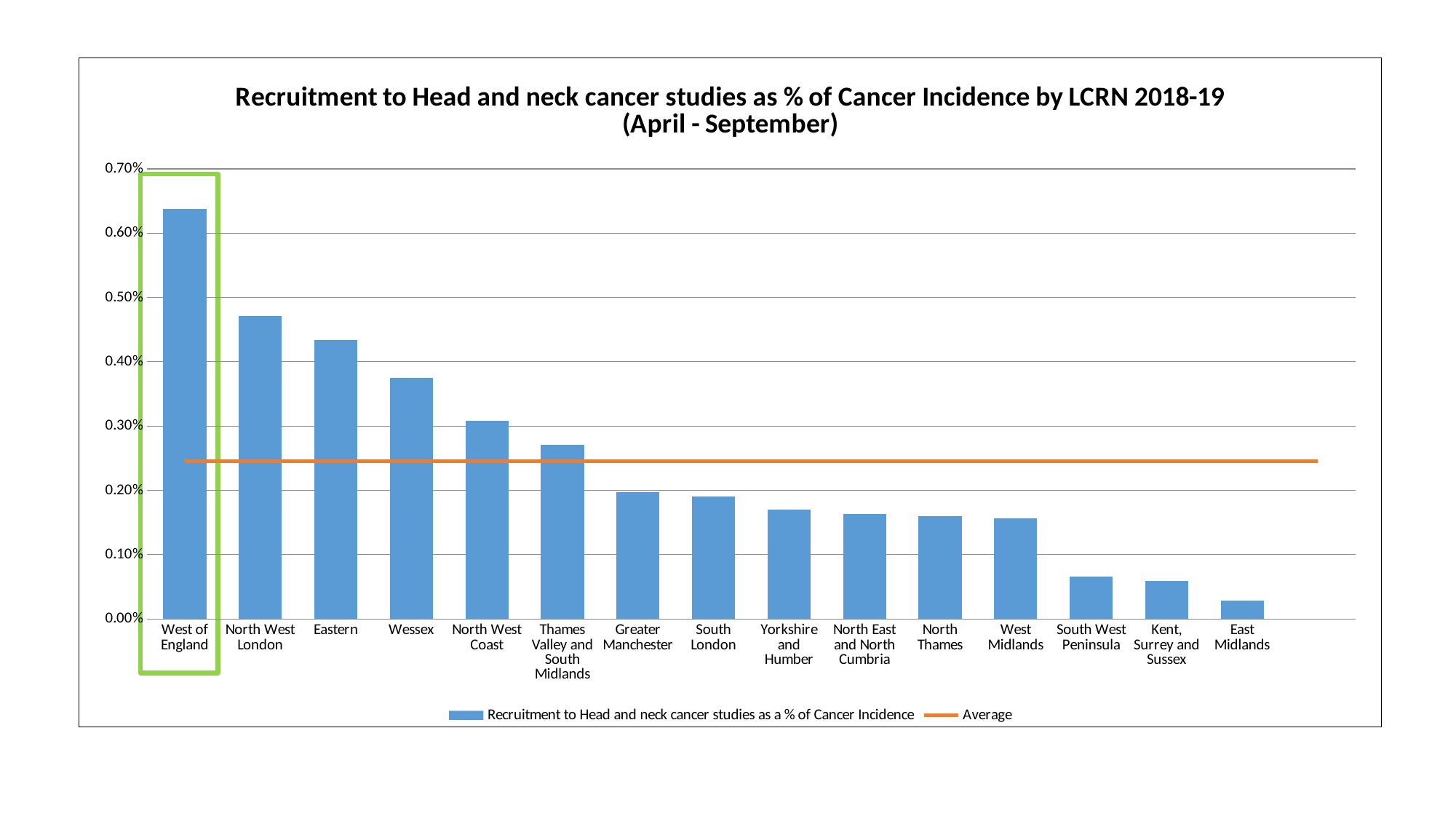
Which is larger, the value for South West Peninsula or the value for West Midlands? West Midlands How many series does the legend list? 2 What does the orange horizontal line represent according to the legend? Average Is the value for Wessex greater or less than 0.40%? less How many LCRNs are shown on the x axis? 15 What kind of chart is shown on the slide? bar chart Which LCRN has the lowest recruitment to head and neck cancer studies as a % of cancer incidence? East Midlands Is the value for West of England greater or less than 0.60%? greater Do the bar values rise or fall from left to right along the x axis? fall Which is larger, the value for Eastern or the value for North West Coast? Eastern Which LCRN has the highest recruitment to head and neck cancer studies as a % of cancer incidence? West of England